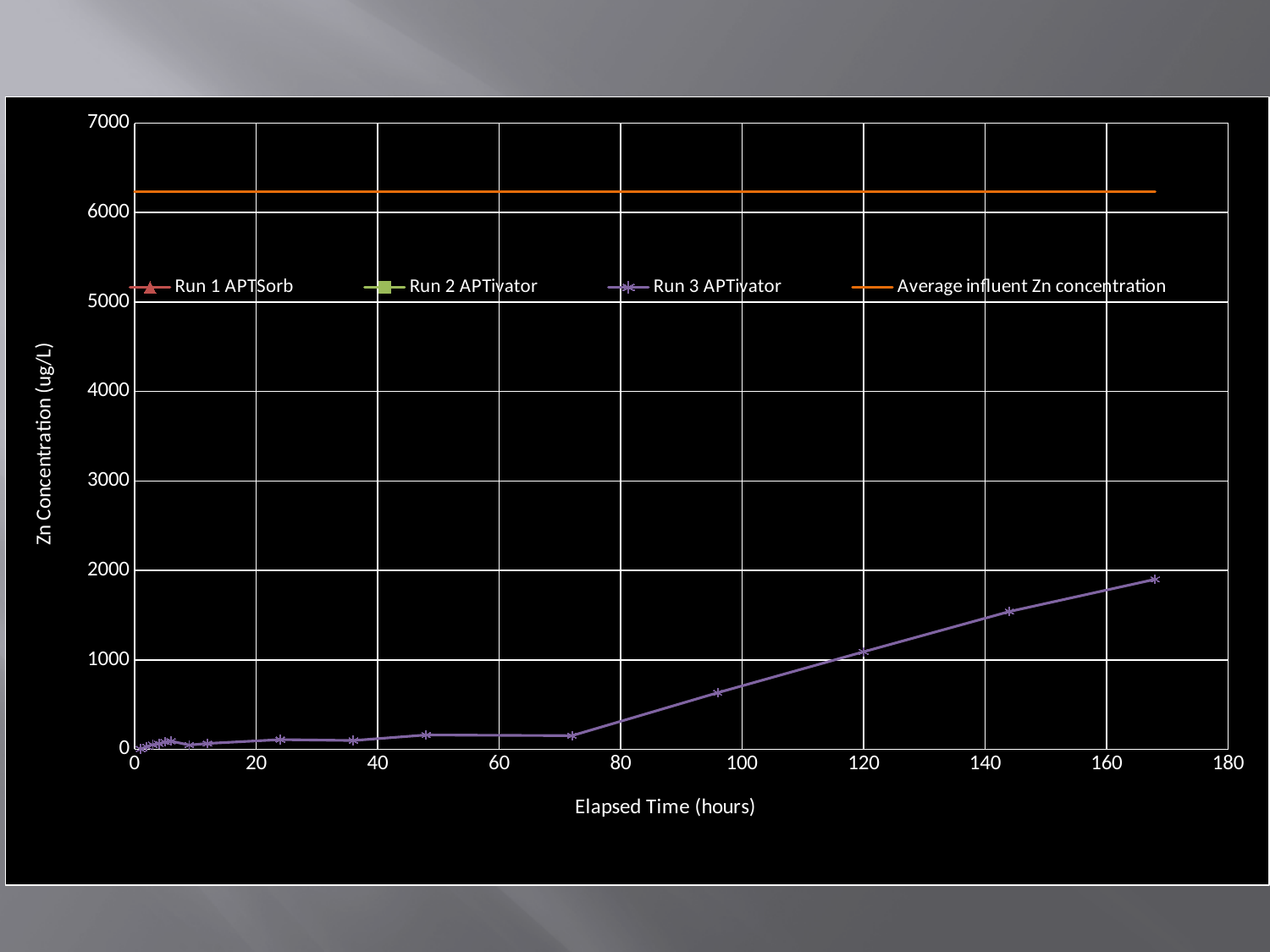
What is the label of the y axis? Zn Concentration (ug/L) Is the value for Run 3 APTivator at 96 hours greater or less than 1000? less What kind of chart is shown on the slide? Line chart Which is larger at 168 hours: the Average influent Zn concentration or Run 3 APTivator? Average influent Zn concentration Is the value for Run 3 APTivator at 168 hours greater or less than 2000? less What is the label of the x axis? Elapsed Time (hours) Is the value for Run 3 APTivator at 72 hours greater or less than 1000? less Which series is the highest on the chart across the whole time range? Average influent Zn concentration Does the Run 3 APTivator series rise or fall as elapsed time increases from 80 to 168 hours? Rise How many series does the legend list? 4